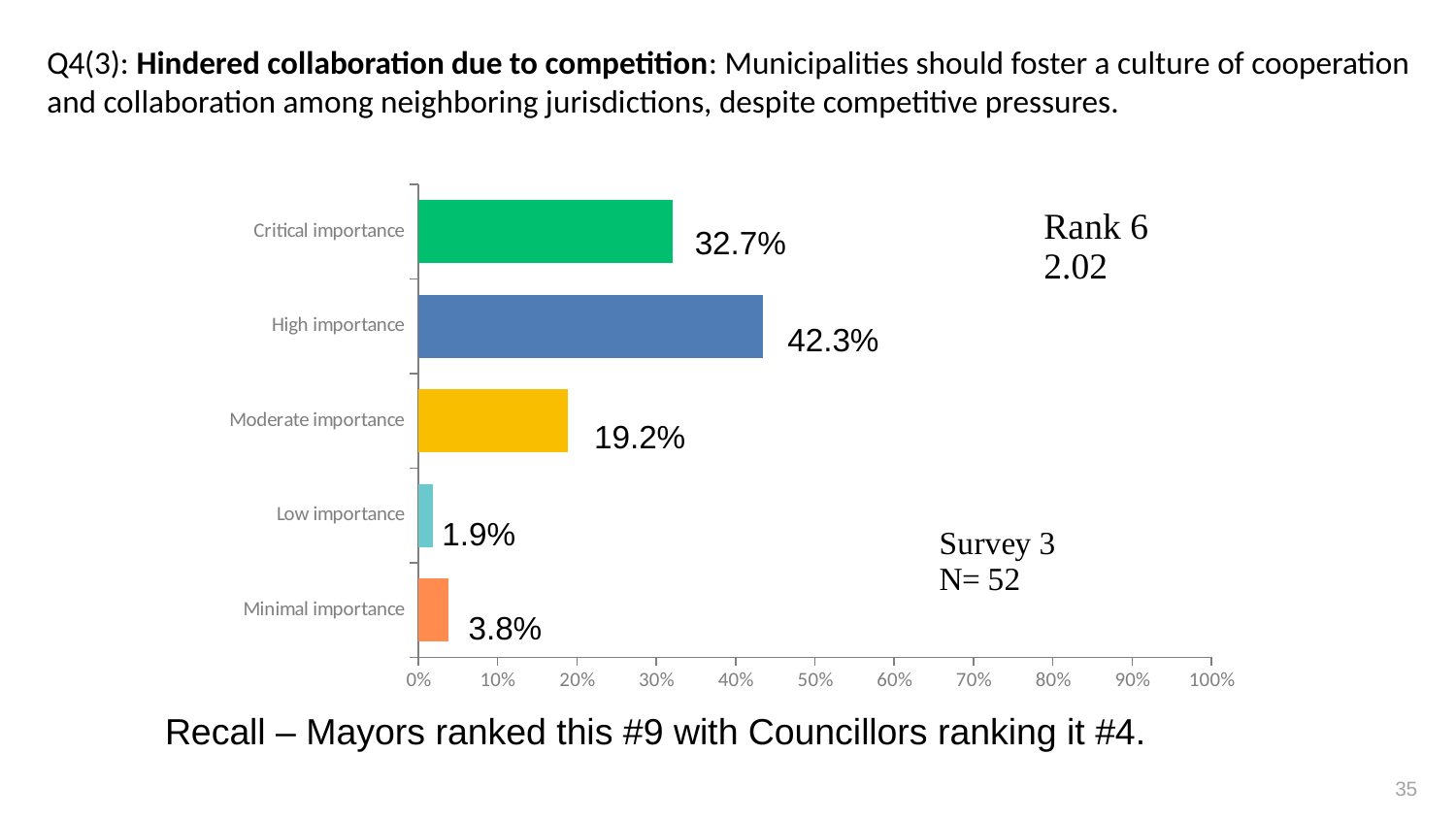
What is the value shown for Moderate importance? 19.2% How many importance categories are shown on the chart? 5 What type of chart is shown on the slide? Bar chart Is the value for High importance greater or less than 40%? greater Which importance category has the lowest percentage? Low importance What percentage of respondents rated this item as Critical importance? 32.7% What is the value shown for Minimal importance? 3.8% What colour is the bar for Moderate importance? Yellow What percentage of respondents rated this item as High importance? 42.3% What is the difference in percentage points between High importance and Critical importance? 9.6 Which importance category has the highest percentage? High importance Which is larger, the value for Minimal importance or the value for Low importance? Minimal importance